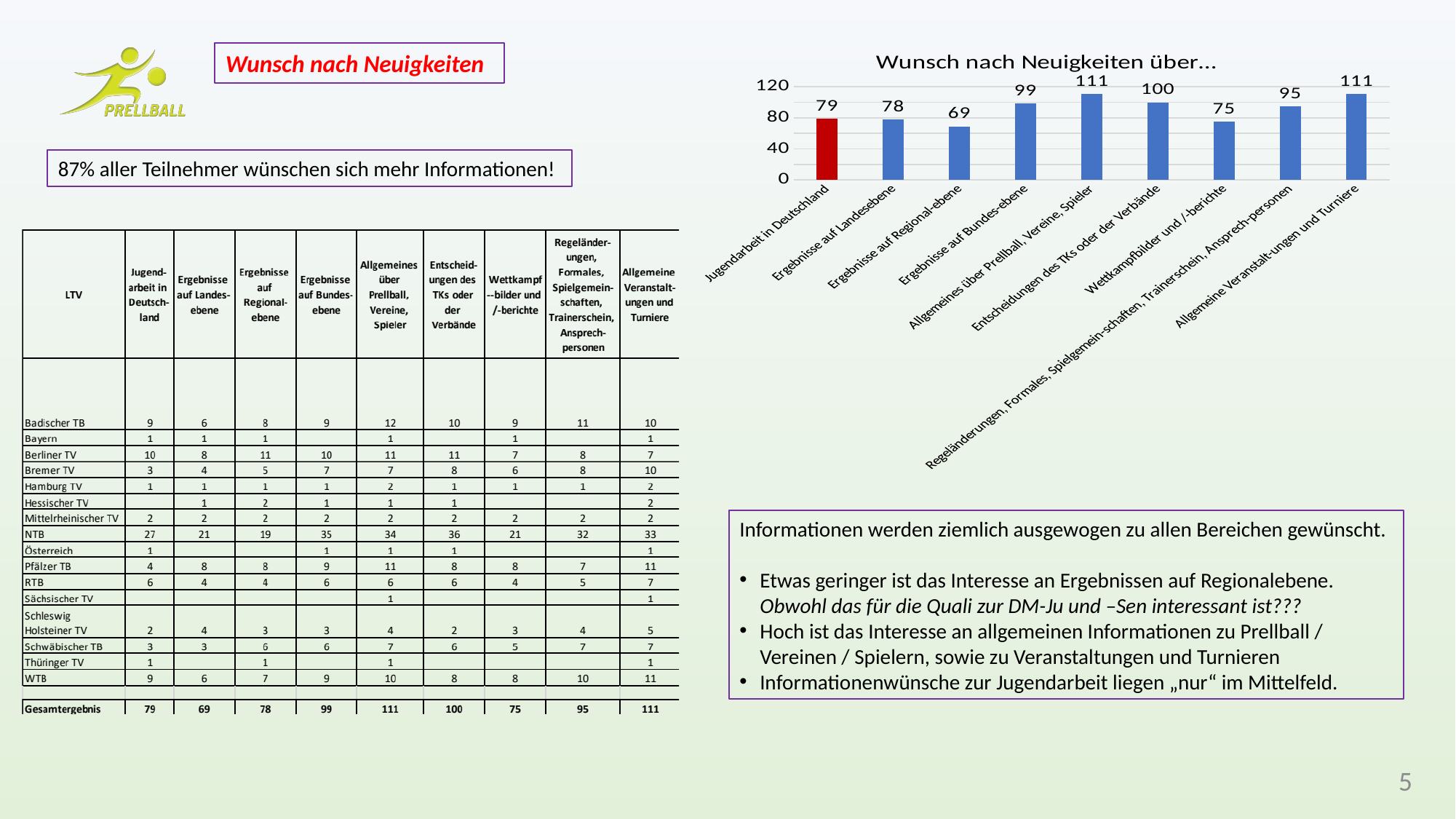
What is the difference between the value for "Allgemeine Veranstalt-ungen und Turniere" and the value for "Ergebnisse auf Regional-ebene"? 42 What is the difference between the values for "Regeländerungen, Formales, Spielgemein-schaften, Trainerschein, Ansprech-personen" and "Wettkampfbilder und /-berichte"? 20 Which category's bar is coloured red in the chart? Jugendarbeit in Deutschland What is the value for "Entscheidungen des TKs oder der Verbände"? 100 Is the value for "Ergebnisse auf Regional-ebene" greater or less than 80? less What value does the chart show for "Wettkampfbilder und /-berichte"? 75 What is the value for "Jugendarbeit in Deutschland" in the chart? 79 What type of chart is shown on the slide? bar chart What is the value for "Ergebnisse auf Bundes-ebene" in the chart? 99 Which is larger: the value for "Ergebnisse auf Landesebene" or the value for "Allgemeines über Prellball, Vereine, Spieler"? Allgemeines über Prellball, Vereine, Spieler Which category has the lowest value in the chart? Ergebnisse auf Regional-ebene How many categories are shown in the chart? 9